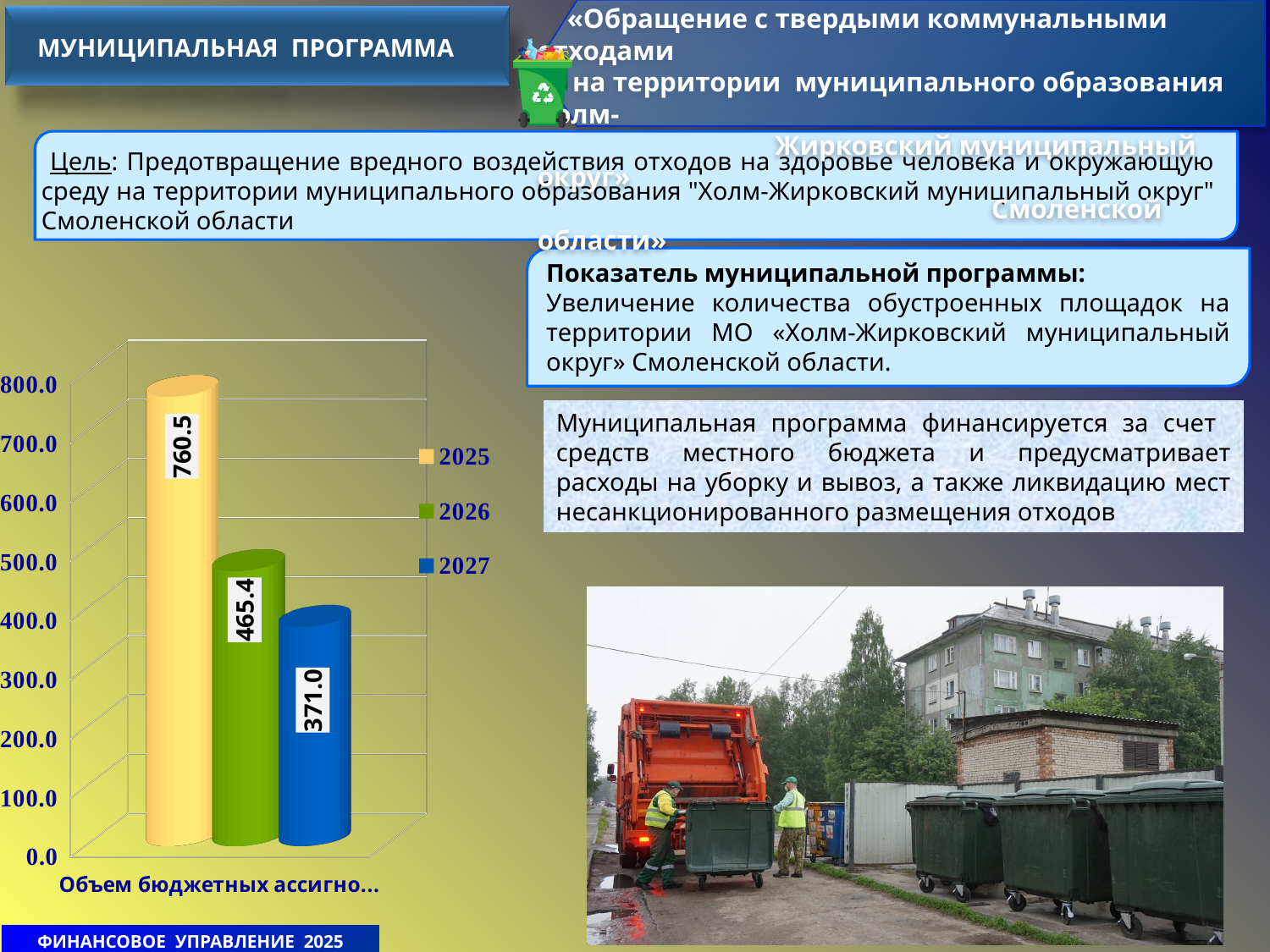
What is the difference between the values for 2026 and 2027? 94.4 What is the value for 2026 on the chart? 465.4 What is the value for 2027 on the chart? 371.0 Which colour represents the 2027 series in the legend? blue What is the value for 2025 on the chart? 760.5 Which year has the lowest value on the chart? 2027 How many series does the legend list? 3 Which is larger, the value for 2026 or the value for 2027? 2026 Which year has the highest value on the chart? 2025 What is the difference between the values for 2025 and 2026? 295.1 What kind of chart is shown on the slide? bar chart Is the value for 2025 greater or less than 700.0? greater